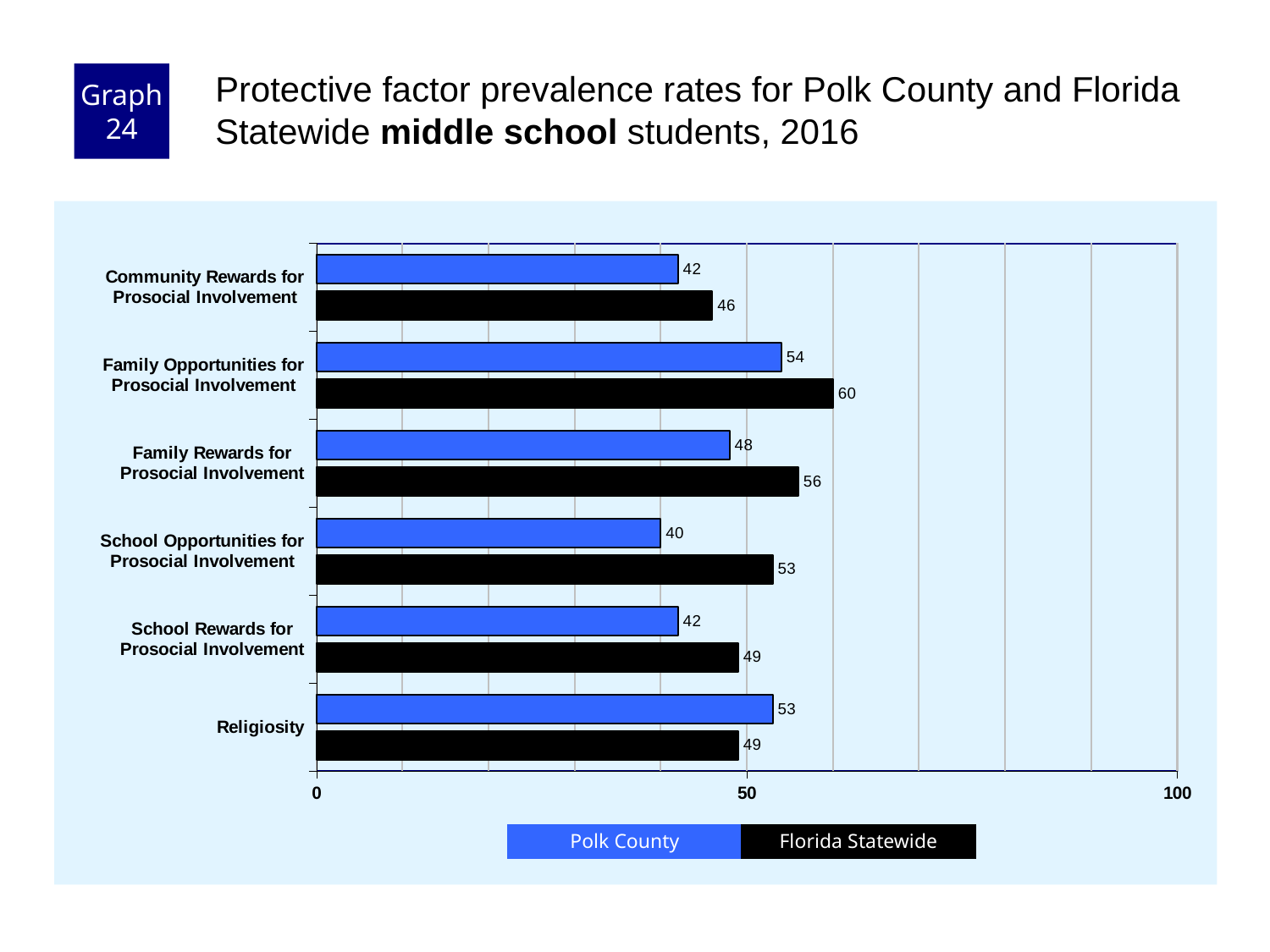
What kind of chart is shown on the slide? bar chart Is the Florida Statewide value for Family Rewards for Prosocial Involvement greater or less than 50? greater What is the Polk County value for Religiosity? 53 What is the Florida Statewide value for School Opportunities for Prosocial Involvement? 53 Which category has the lowest Polk County value? School Opportunities for Prosocial Involvement Which category has the highest Florida Statewide value? Family Opportunities for Prosocial Involvement For Religiosity, which is larger: the Polk County value or the Florida Statewide value? Polk County What colour are the Florida Statewide bars? black How many categories are shown on the chart? 6 How many series does the legend list? 2 What is the Polk County value for Family Opportunities for Prosocial Involvement? 54 What is the difference between the Florida Statewide and Polk County values for School Opportunities for Prosocial Involvement? 13